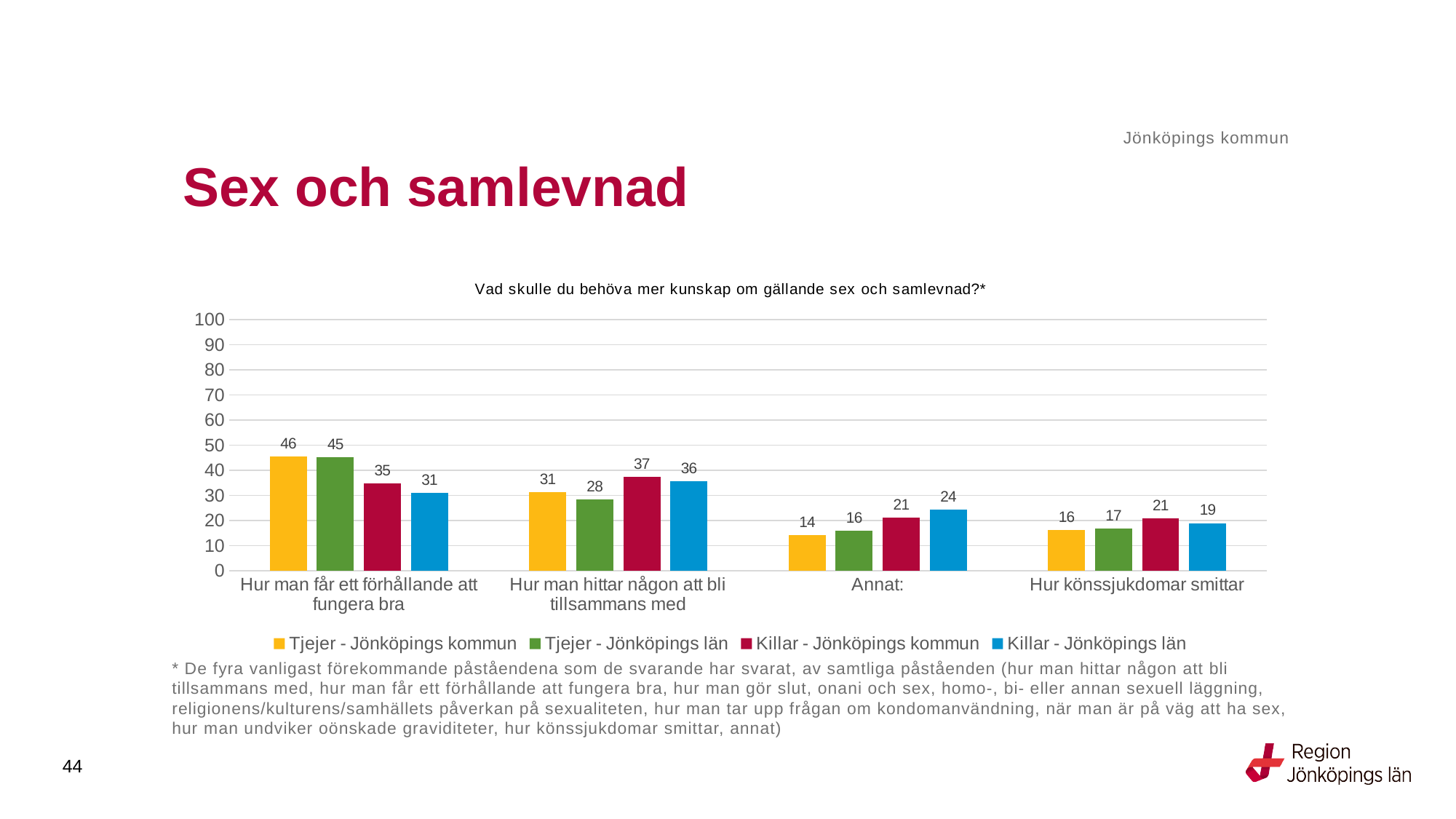
How many series does the legend list? 4 What is the title of the chart? Vad skulle du behöva mer kunskap om gällande sex och samlevnad?* What is the difference between 'Tjejer - Jönköpings kommun' and 'Killar - Jönköpings län' in the category 'Hur man får ett förhållande att fungera bra'? 15 What is the value for 'Tjejer - Jönköpings kommun' in the category 'Hur man får ett förhållande att fungera bra'? 46 Which category has the lowest value for 'Killar - Jönköpings län'? Hur könssjukdomar smittar In the category 'Annat:', which is larger: 'Tjejer - Jönköpings kommun' or 'Killar - Jönköpings kommun'? Killar - Jönköpings kommun What kind of chart is shown on the slide? Bar chart What is the value for 'Killar - Jönköpings kommun' in the category 'Hur man hittar någon att bli tillsammans med'? 37 What is the value for 'Killar - Jönköpings län' in the category 'Annat:'? 24 What is the value for 'Tjejer - Jönköpings län' in the category 'Hur könssjukdomar smittar'? 17 Which category has the highest value for 'Tjejer - Jönköpings kommun'? Hur man får ett förhållande att fungera bra How many categories are shown on the x axis? 4